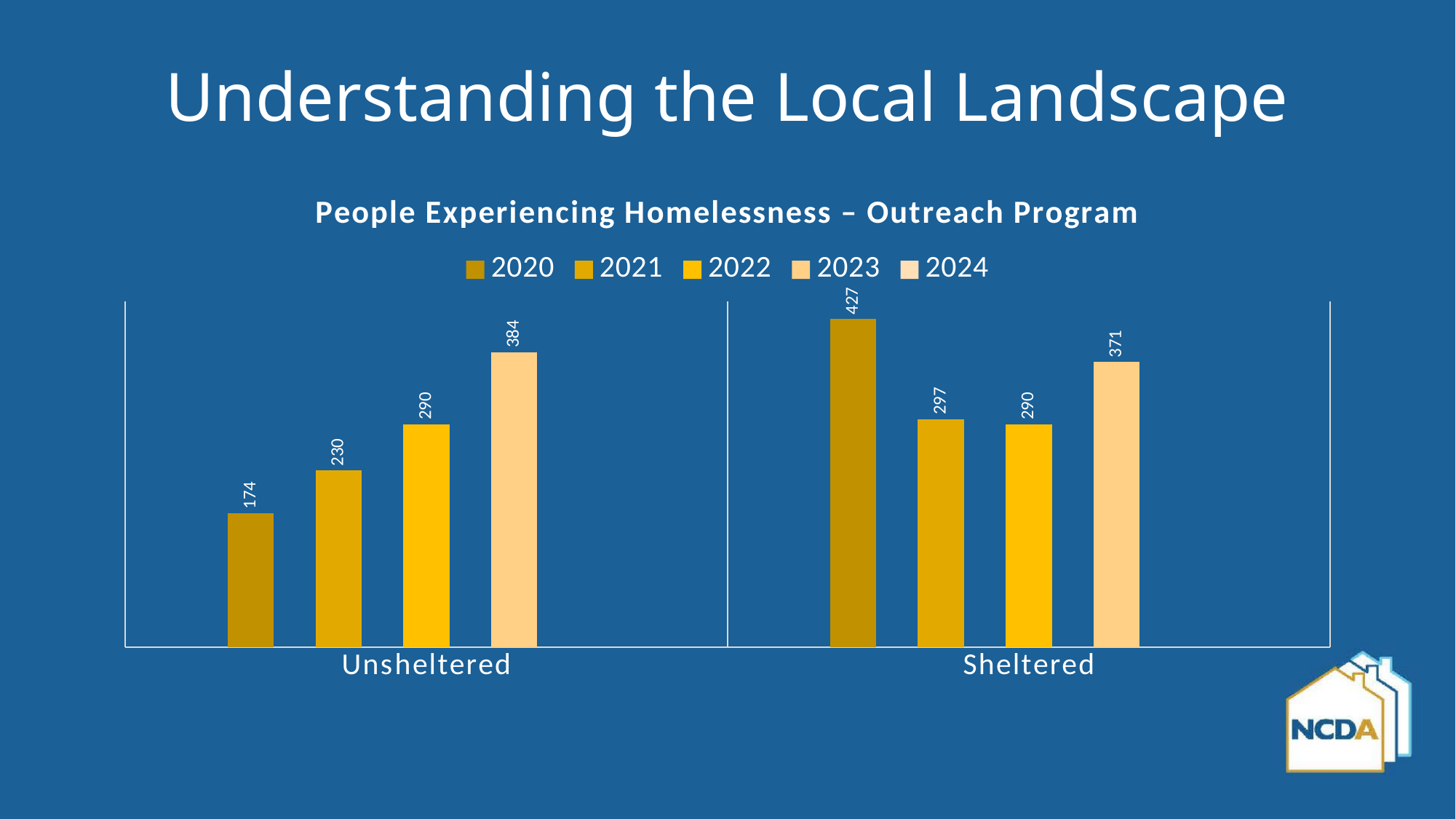
What is the value of the 2020 bar for Unsheltered? 174 What is the difference between the 2021 and 2020 values for Unsheltered? 56 Which bar has the highest value on the chart? 2020 Sheltered (427) What is the value of the 2022 bar for Sheltered? 290 What is the value of the 2020 bar for Sheltered? 427 How many series does the legend list? 5 Do the bars in the Unsheltered group rise or fall from left to right? Rise What kind of chart is shown on the slide? Bar chart What is the value of the 2021 bar for Unsheltered? 230 Which is larger, the 2021 value for Unsheltered or the 2021 value for Sheltered? Sheltered Which bar has the lowest value on the chart? 2020 Unsheltered (174) How many categories are shown on the x axis? 2